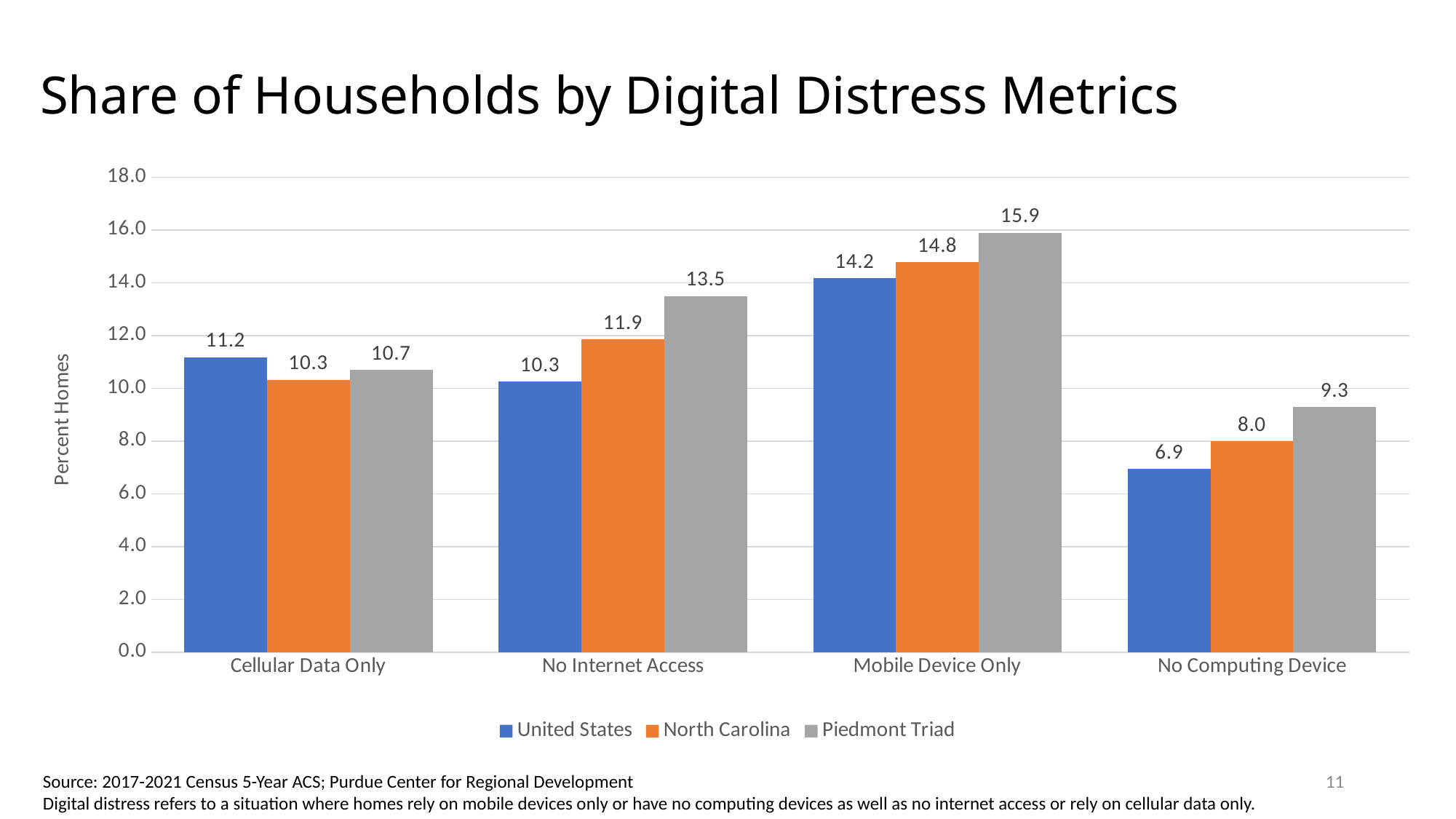
Which category has the highest value for Piedmont Triad? Mobile Device Only How many categories are shown on the x axis? 4 How many series does the legend list? 3 What is the label of the y axis? Percent Homes What is the value for North Carolina in the No Internet Access category? 11.9 What is the difference between the Piedmont Triad and United States values in the No Internet Access category? 3.2 In the Cellular Data Only category, which is larger: United States or Piedmont Triad? United States Is the value for North Carolina in the Mobile Device Only category greater or less than 14.0? greater Which category has the lowest value for North Carolina? No Computing Device What kind of chart is shown on the slide? Bar chart What is the value for Piedmont Triad in the Mobile Device Only category? 15.9 What is the value for United States in the No Computing Device category? 6.9